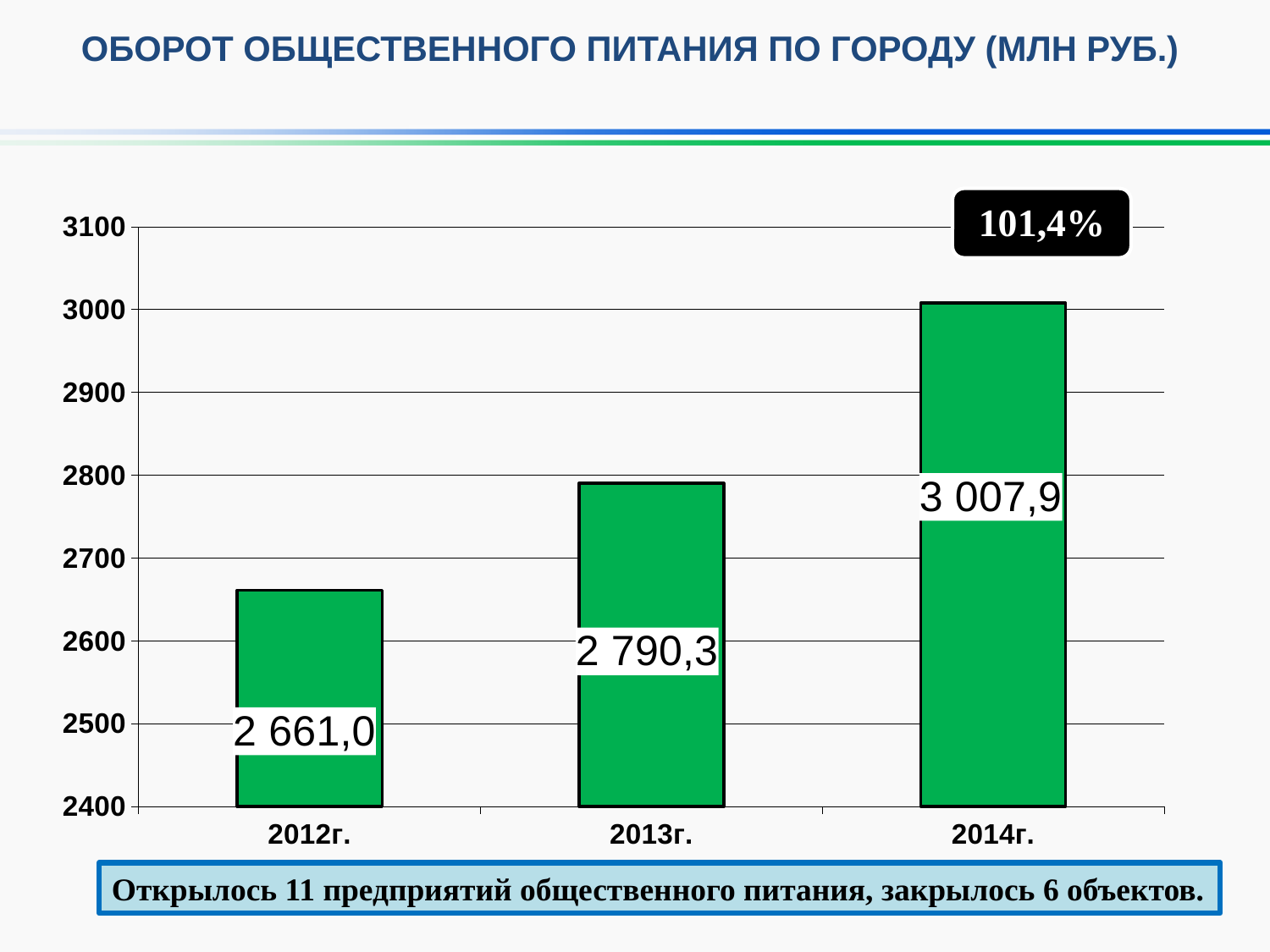
What kind of chart is shown on the slide? bar chart What is the value for 2013г.? 2 790,3 Which year has the highest value? 2014г. Do the values rise or fall from 2012г. to 2014г.? rise Which is larger, the value for 2012г. or the value for 2013г.? 2013г. How many years are shown on the chart? 3 Is the value for 2014г. greater or less than 3000? greater What is the difference between the values for 2014г. and 2013г.? 217,6 Which year has the lowest value? 2012г. What is the value for 2012г.? 2 661,0 What is the value for 2014г.? 3 007,9 What is the difference between the values for 2013г. and 2012г.? 129,3